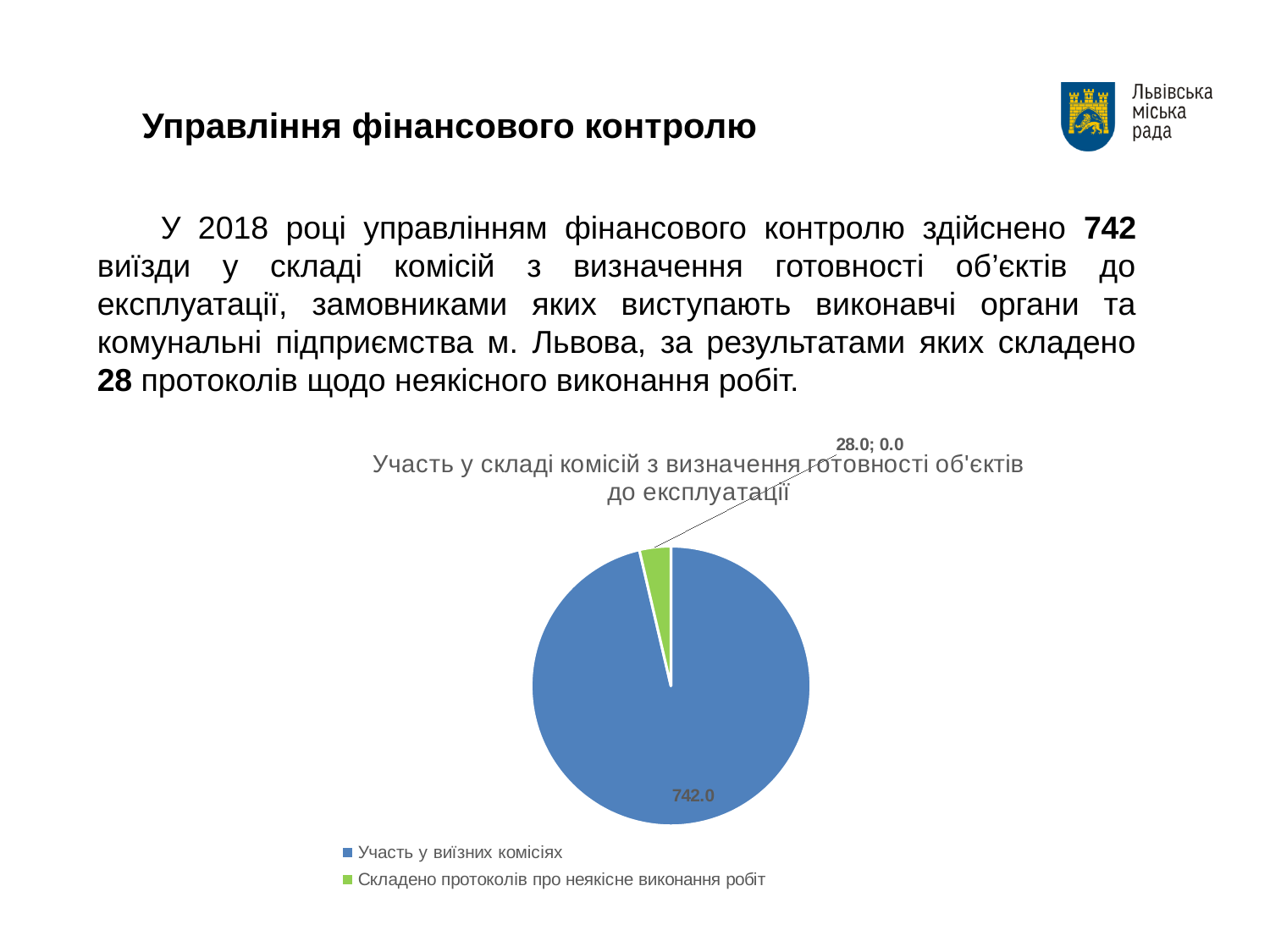
Which is larger: "Участь у виїзних комісіях" or "Складено протоколів про неякісне виконання робіт"? Участь у виїзних комісіях How many slices does the pie chart have? 2 What is the value for "Складено протоколів про неякісне виконання робіт" in the pie chart? 28.0 What kind of chart is shown on the slide? pie chart What is the title of the pie chart? Участь у складі комісій з визначення готовності об'єктів до експлуатації Which category has the largest slice in the pie chart? Участь у виїзних комісіях Which category has the smallest slice in the pie chart? Складено протоколів про неякісне виконання робіт What colour is the slice labelled 28.0 in the pie chart? green How many entries does the legend of the pie chart list? 2 What is the value for "Участь у виїзних комісіях" in the pie chart? 742.0 What is the difference between the value for "Участь у виїзних комісіях" and the value for "Складено протоколів про неякісне виконання робіт"? 714.0